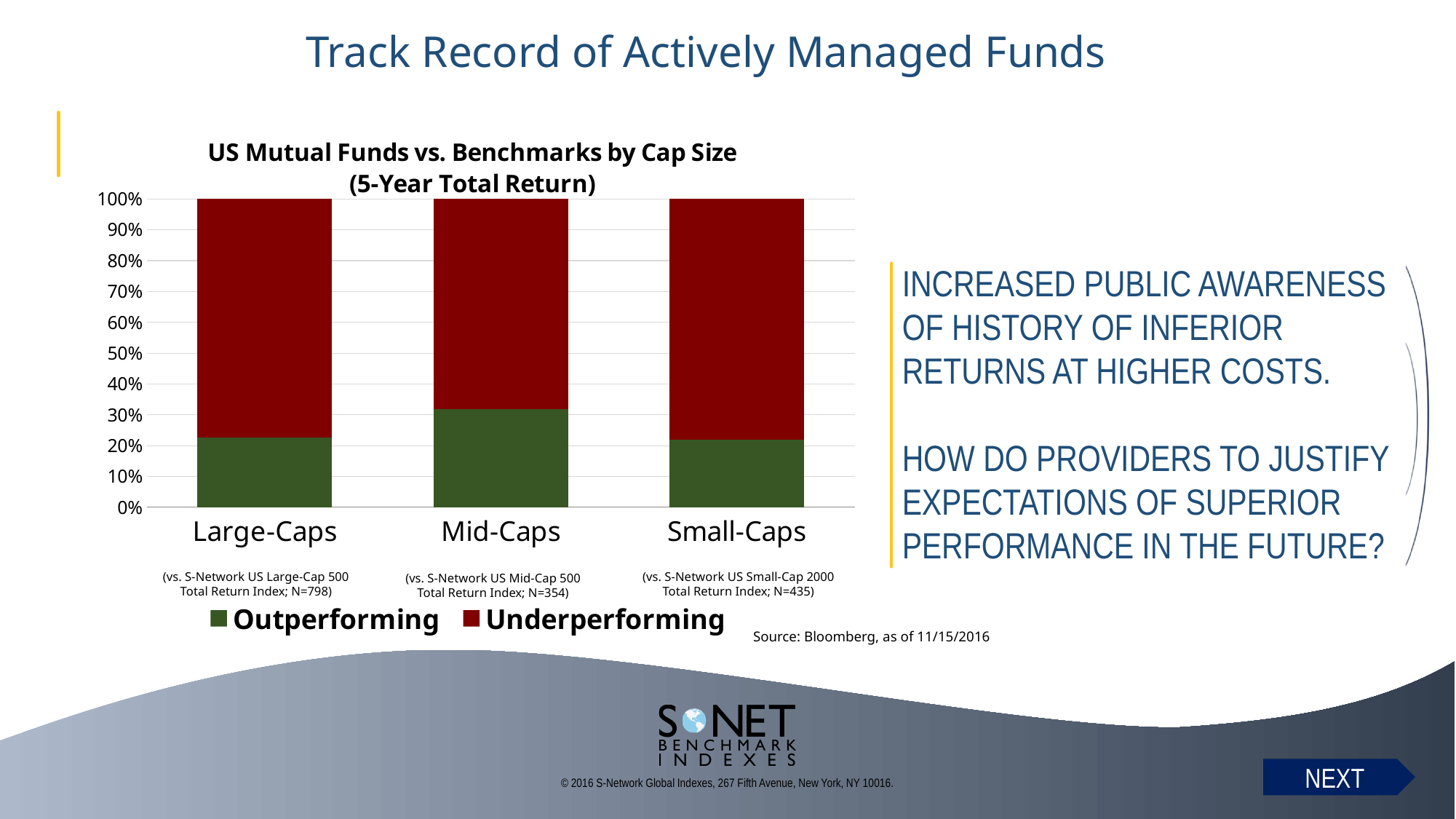
Is the Outperforming value for Large-Caps greater or less than 30%? less What kind of chart is shown on the slide? Stacked bar chart Is the Outperforming value for Mid-Caps greater or less than 30%? greater What is the total height of each stacked bar in the chart? 100% Which cap-size category has the largest Outperforming share? Mid-Caps Which series is shown in dark red in the chart? Underperforming What is the title of the chart? US Mutual Funds vs. Benchmarks by Cap Size (5-Year Total Return) How many categories are shown on the x axis of the chart? 3 Is the Underperforming value for Large-Caps greater or less than 70%? greater How many series does the chart legend list? 2 Which cap-size category has the largest Underperforming share? Small-Caps